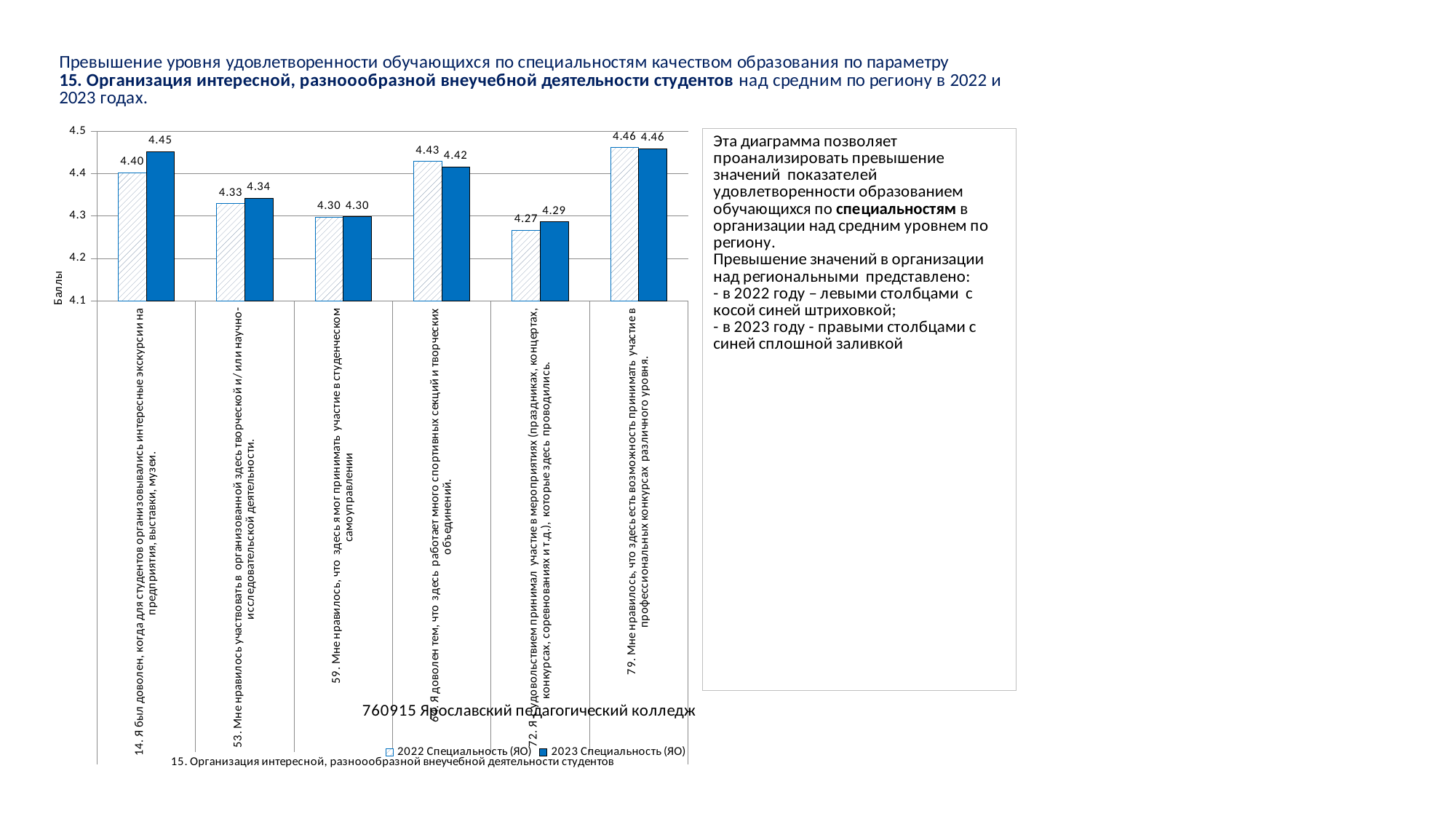
What is the label on the vertical axis of the chart? Баллы Is the 2022 Специальность (ЯО) value for category 59 (участие в студенческом самоуправлении) greater or less than 4.4? less How many categories are plotted on the x axis? 6 How many series does the legend list? 2 What type of chart is shown on the slide? bar chart Which category has the lowest 2022 Специальность (ЯО) value? 72. Я с удовольствием принимал участие в мероприятиях (праздниках, концертах, конкурсах, соревнованиях и т.д.), которые здесь проводились For category 72 (участие в мероприятиях), which is larger: the 2022 value or the 2023 value? 2023 What is the 2022 Специальность (ЯО) value for category 53 (Мне нравилось участвовать в организованной здесь творческой и/или научно-исследовательской деятельности)? 4.33 What is the 2022 Специальность (ЯО) value for category 72 (Я с удовольствием принимал участие в мероприятиях)? 4.27 What is the 2023 Специальность (ЯО) value for category 14 (Я был доволен, когда для студентов организовывались интересные экскурсии)? 4.45 Which category has the highest 2023 Специальность (ЯО) value? 79. Мне нравилось, что здесь есть возможность принимать участие в профессиональных конкурсах различного уровня What is the difference between the 2023 and 2022 values for category 14 (интересные экскурсии на предприятия, выставки, музеи)? 0.05